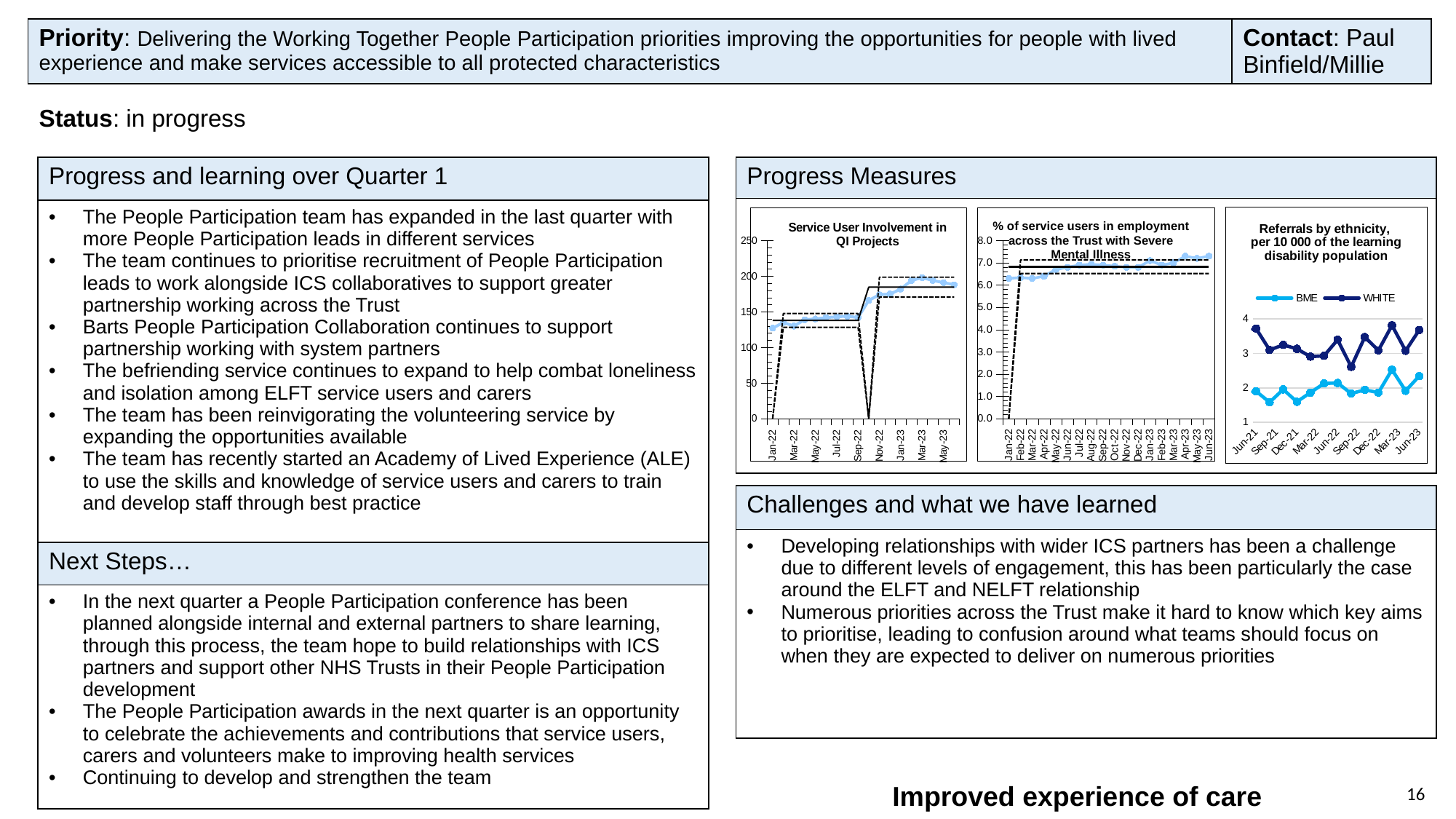
In the 'Referrals by ethnicity, per 10 000 of the learning disability population' chart, which series is higher at Jun-21, BME or WHITE? WHITE What kind of chart is the 'Service User Involvement in QI Projects' chart? line chart In the '% of service users in employment across the Trust with Severe Mental Illness' chart, is the value for Jan-22 greater or less than 7.0? less How many series does the legend of the 'Referrals by ethnicity, per 10 000 of the learning disability population' chart list? 2 How many charts are shown in the Progress Measures section of the slide? 3 In the '% of service users in employment across the Trust with Severe Mental Illness' chart, do the values generally rise or fall over the period shown? rise In the 'Service User Involvement in QI Projects' chart, is the value for May-23 greater or less than 150? greater In the 'Service User Involvement in QI Projects' chart, is the value for Jan-22 greater or less than 150? less What are the two series named in the legend of the 'Referrals by ethnicity, per 10 000 of the learning disability population' chart? BME and WHITE In the 'Service User Involvement in QI Projects' chart, do the values generally rise or fall from Jan-22 to May-23? rise